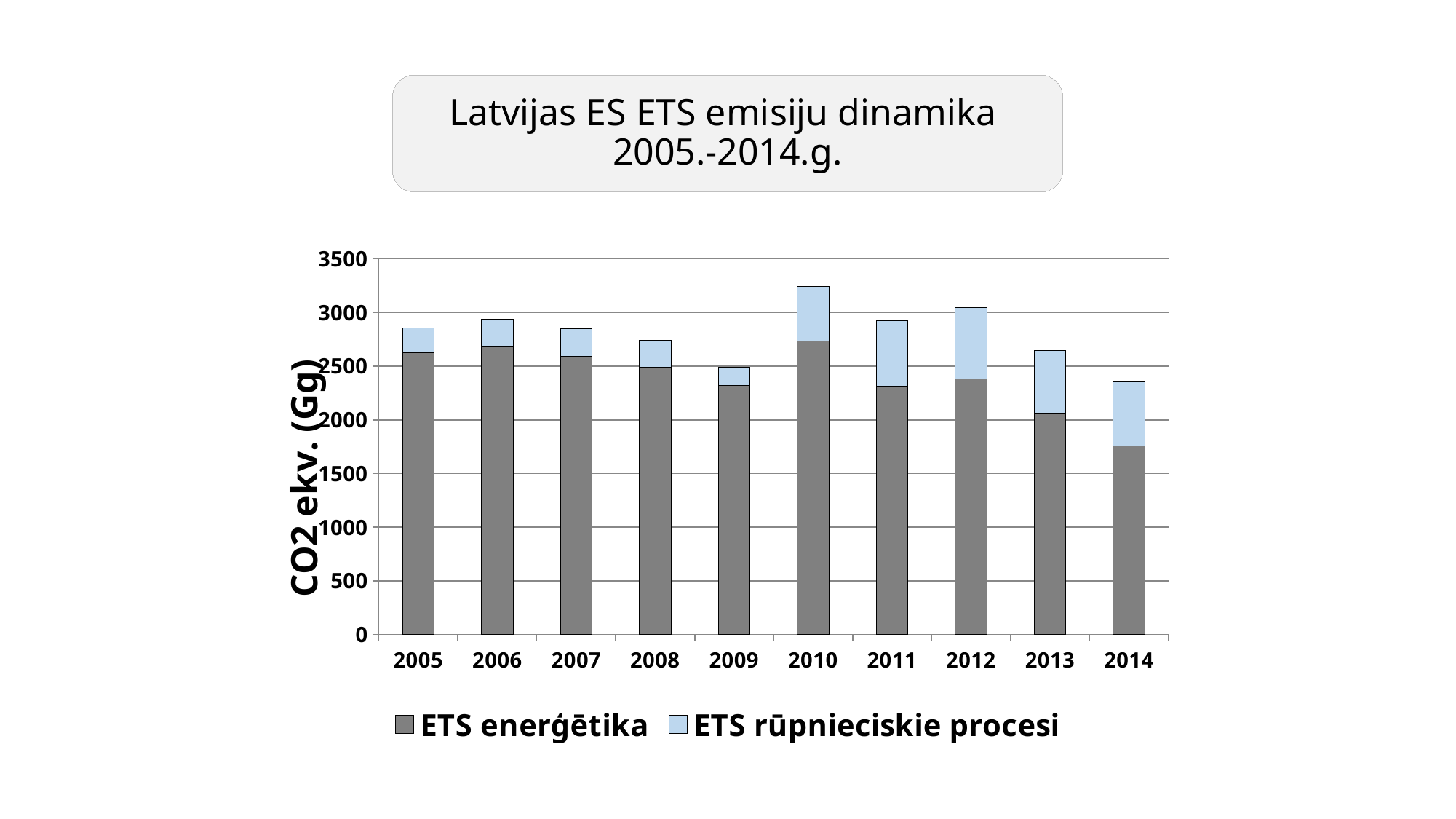
Is the total stacked bar for 2010 greater or less than 3000? greater How many years are shown on the x axis of the chart? 10 What kind of chart is shown on the slide? Stacked bar chart Which year has the highest total ETS emissions in the chart? 2010 Is the value for ETS enerģētika in 2005 greater or less than 2500? greater How many series does the chart legend list? 2 Do the total stacked bars rise or fall from 2010 to 2014? fall Which year has the lowest total ETS emissions in the chart? 2014 Which year has the lowest value for ETS enerģētika? 2014 Which is larger, the total bar for 2009 or the total bar for 2010? 2010 What is the label on the vertical axis of the chart? CO2 ekv. (Gg) Is the value for ETS enerģētika in 2014 greater or less than 2000? less